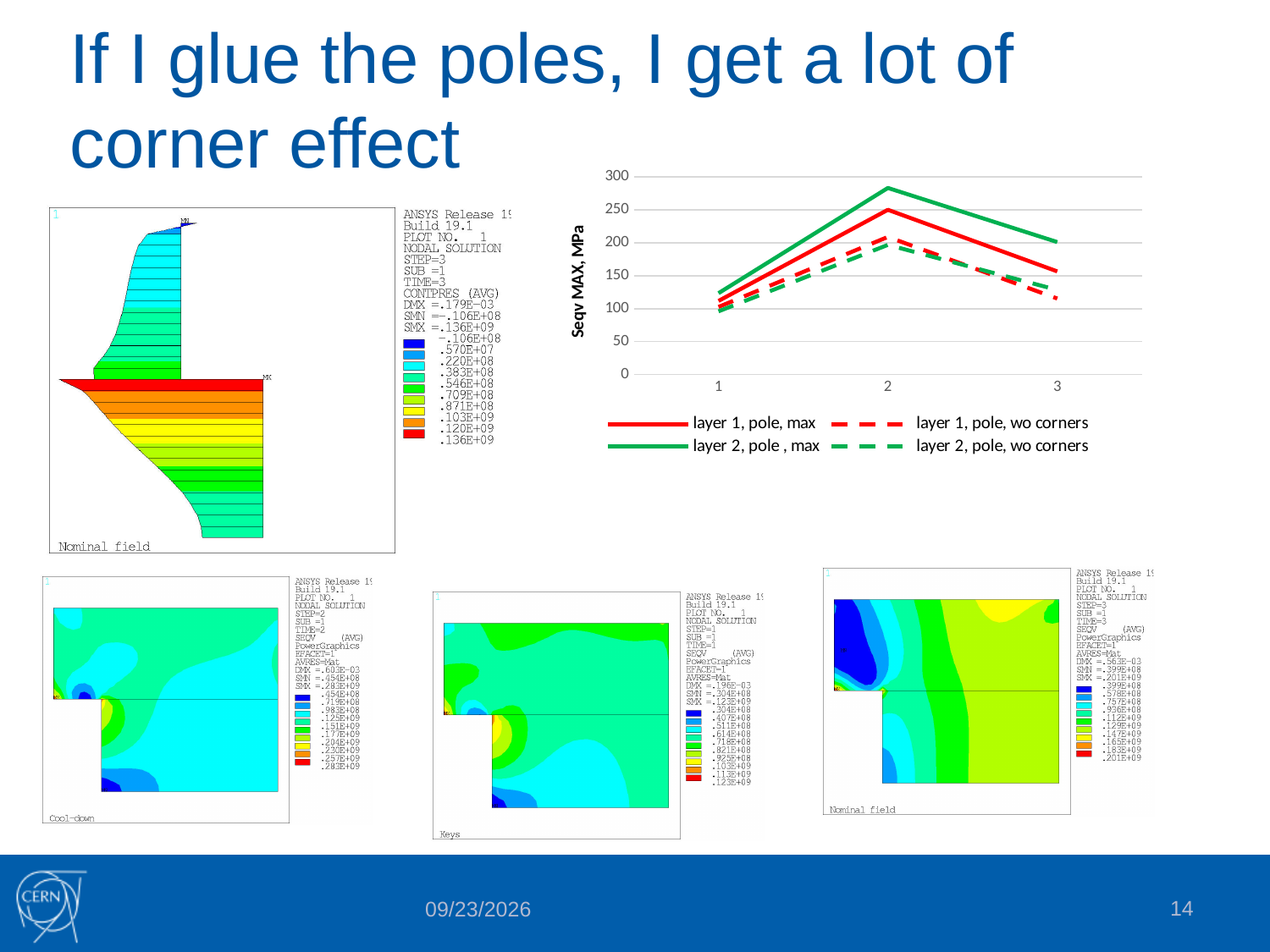
In the line chart, how many points are on the x axis? 3 In the line chart, is the value of 'layer 2, pole , max' at x = 1 greater or less than 150? less In the line chart, which series is drawn as a solid green line? layer 2, pole , max In the line chart, is the value of 'layer 2, pole , max' at x = 2 greater or less than 250? greater In the line chart, at x = 3, which is larger: 'layer 1, pole, max' or 'layer 2, pole , max'? layer 2, pole , max In the line chart, is the value of 'layer 1, pole, max' at x = 2 greater or less than 200? greater In the line chart, what is the label of the y axis? Seqv MAX, MPa In the line chart, what kind of chart is it? line chart In the line chart, do the values of 'layer 1, pole, max' rise or fall from x = 2 to x = 3? fall In the line chart, how many series does the legend list? 4 In the line chart, which series has the highest value at x = 2? layer 2, pole , max